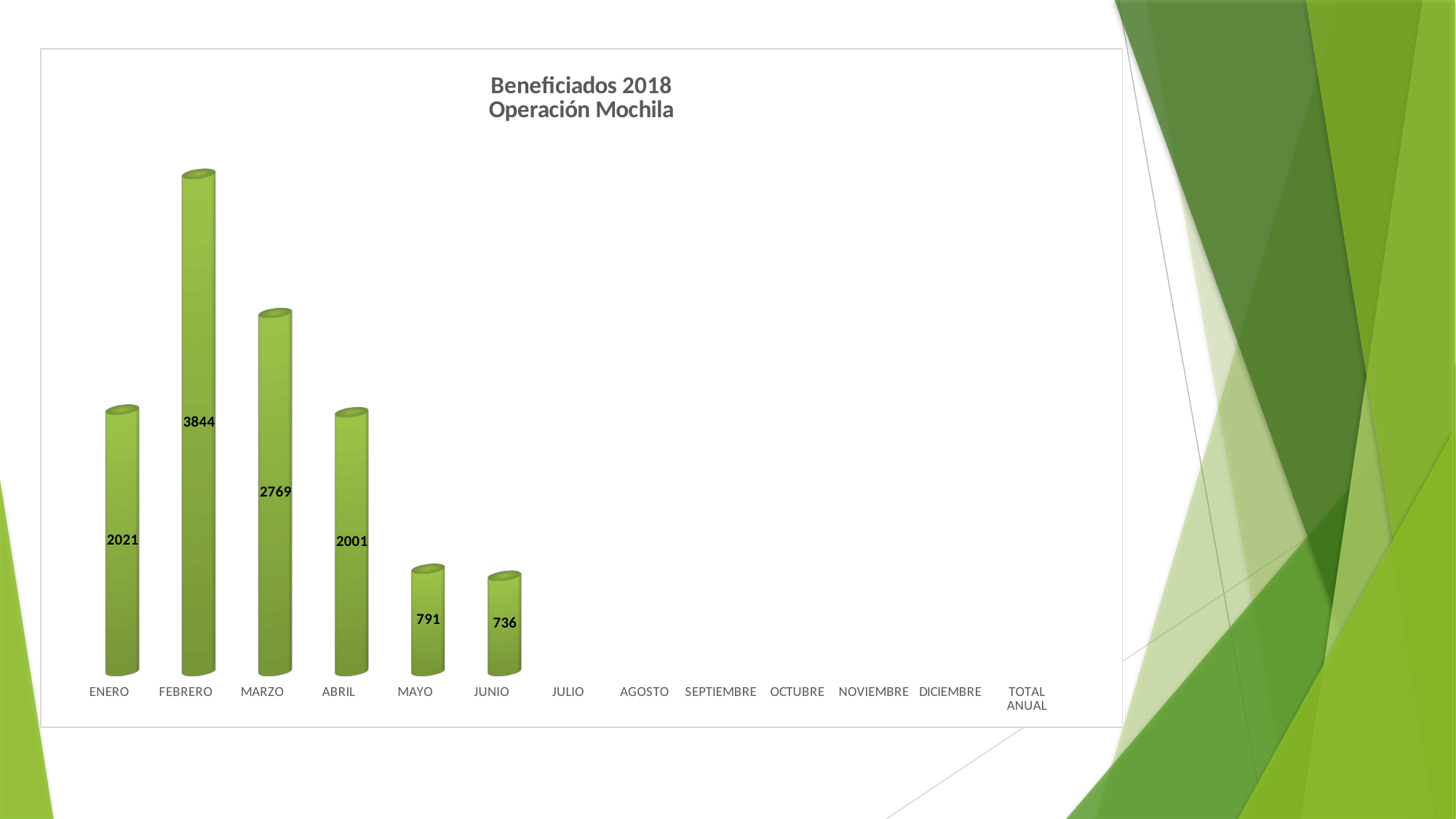
What kind of chart is shown? bar chart What is the value for MAYO? 791 What is the difference between the values for MAYO and JUNIO? 55 Which is larger, the value for ENERO or the value for ABRIL? ENERO What is the value for ENERO? 2021 What is the title of the chart? Beneficiados 2018 Operación Mochila What is the value for FEBRERO? 3844 Among the months with plotted bars, which has the lowest value? JUNIO What is the difference between the values for FEBRERO and MARZO? 1075 How many category labels are shown on the x axis? 13 Which month has the highest value? FEBRERO How many bars are plotted on the chart? 6